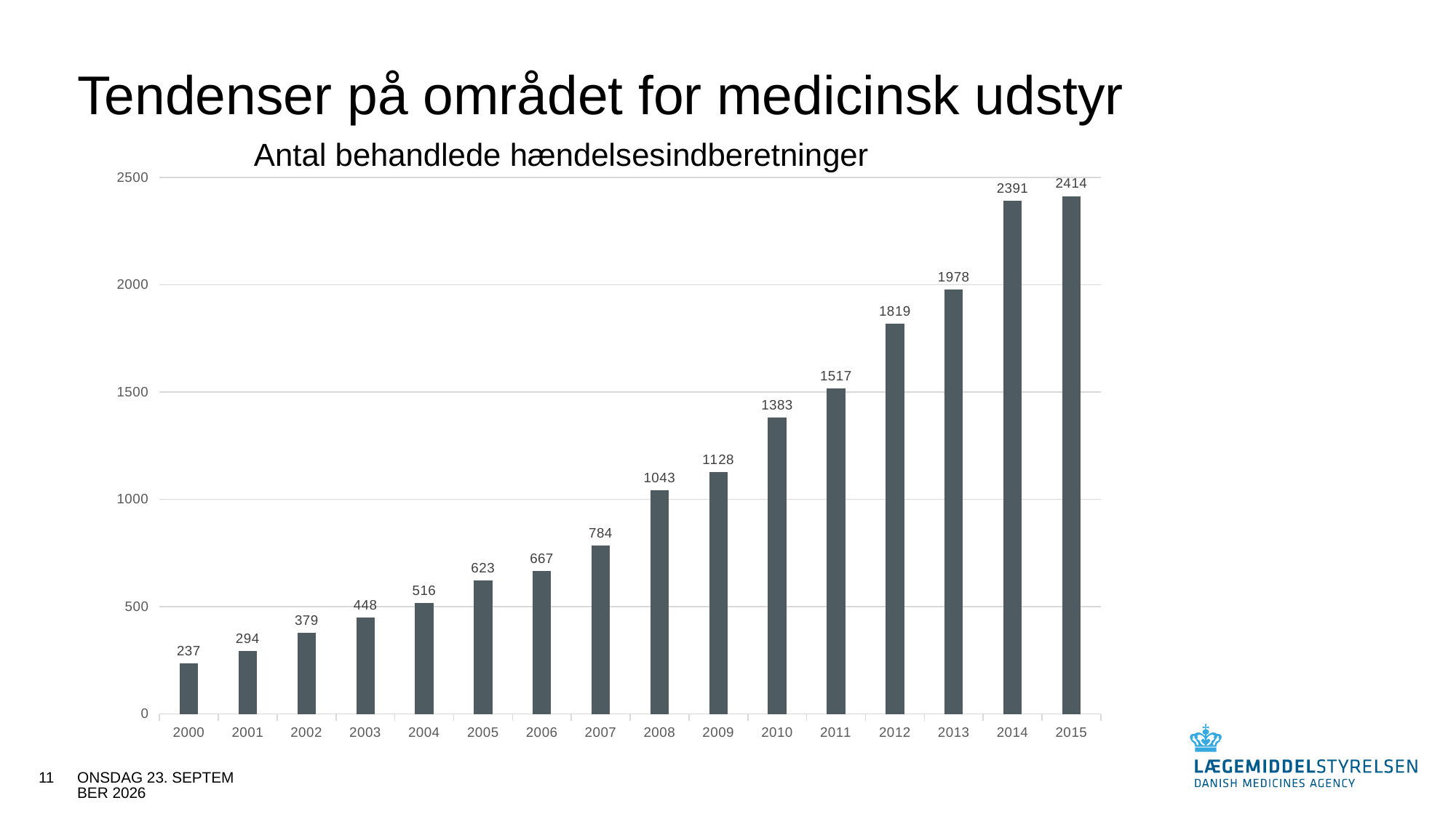
Which is larger, the value for 2005 or the value for 2006? 2006 What is the value for 2000? 237 Which year has the lowest value? 2000 What is the value for 2008? 1043 Which year has the highest value? 2015 Do the values rise or fall from 2000 to 2015? Rise How many years are shown on the x axis? 16 What is the difference between the values for 2012 and 2011? 302 What is the difference between the values for 2015 and 2014? 23 What is the value for 2013? 1978 Is the value for 2009 greater or less than 1000? greater What kind of chart is shown on the slide? Bar chart